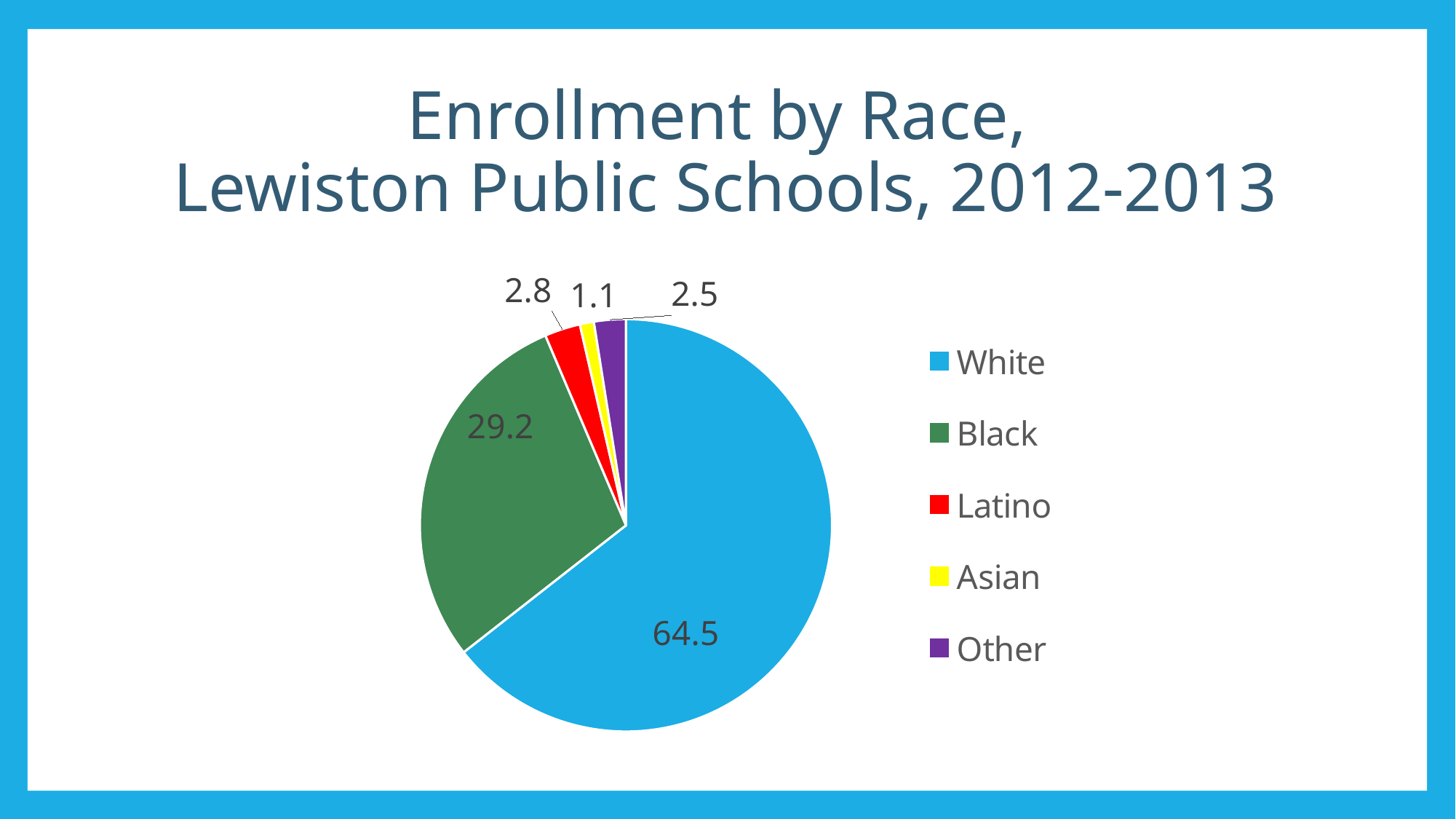
What is the value for Other? 2.5 What is the value for White? 64.5 How many categories does the legend list? 5 What colour is the slice for Black? Green What is the difference between the values for White and Black? 35.3 What is the value for Black? 29.2 Which category has the smallest slice? Asian What is the value for Latino? 2.8 Which category has the largest slice? White What kind of chart is shown on the slide? Pie chart Which is larger, the value for Latino or the value for Other? Latino What is the value for Asian? 1.1